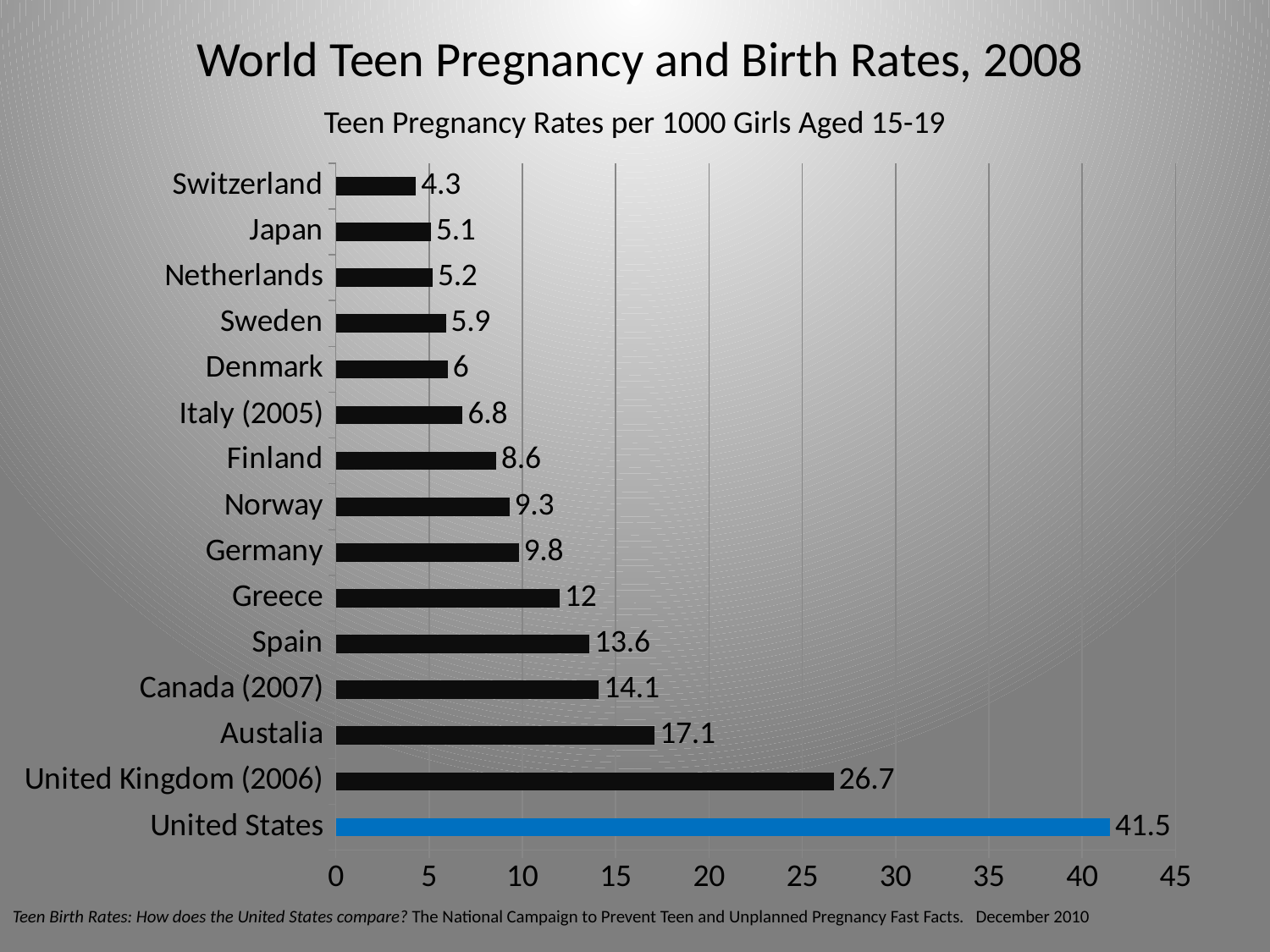
How many countries are shown on the chart? 15 What is the difference between the teen pregnancy rates of the United States and the United Kingdom (2006)? 14.8 Which has a higher teen pregnancy rate, Spain or Greece? Spain Which country has the lowest teen pregnancy rate on the chart? Switzerland Is the value for Austalia greater or less than 15? greater What is the title of the chart? Teen Pregnancy Rates per 1000 Girls Aged 15-19 What kind of chart is shown on the slide? Bar chart What is the teen pregnancy rate for Germany? 9.8 What is the teen pregnancy rate for Canada (2007)? 14.1 Which country has the highest teen pregnancy rate on the chart? United States What is the teen pregnancy rate for the United States? 41.5 Which country's bar is coloured blue rather than black? United States